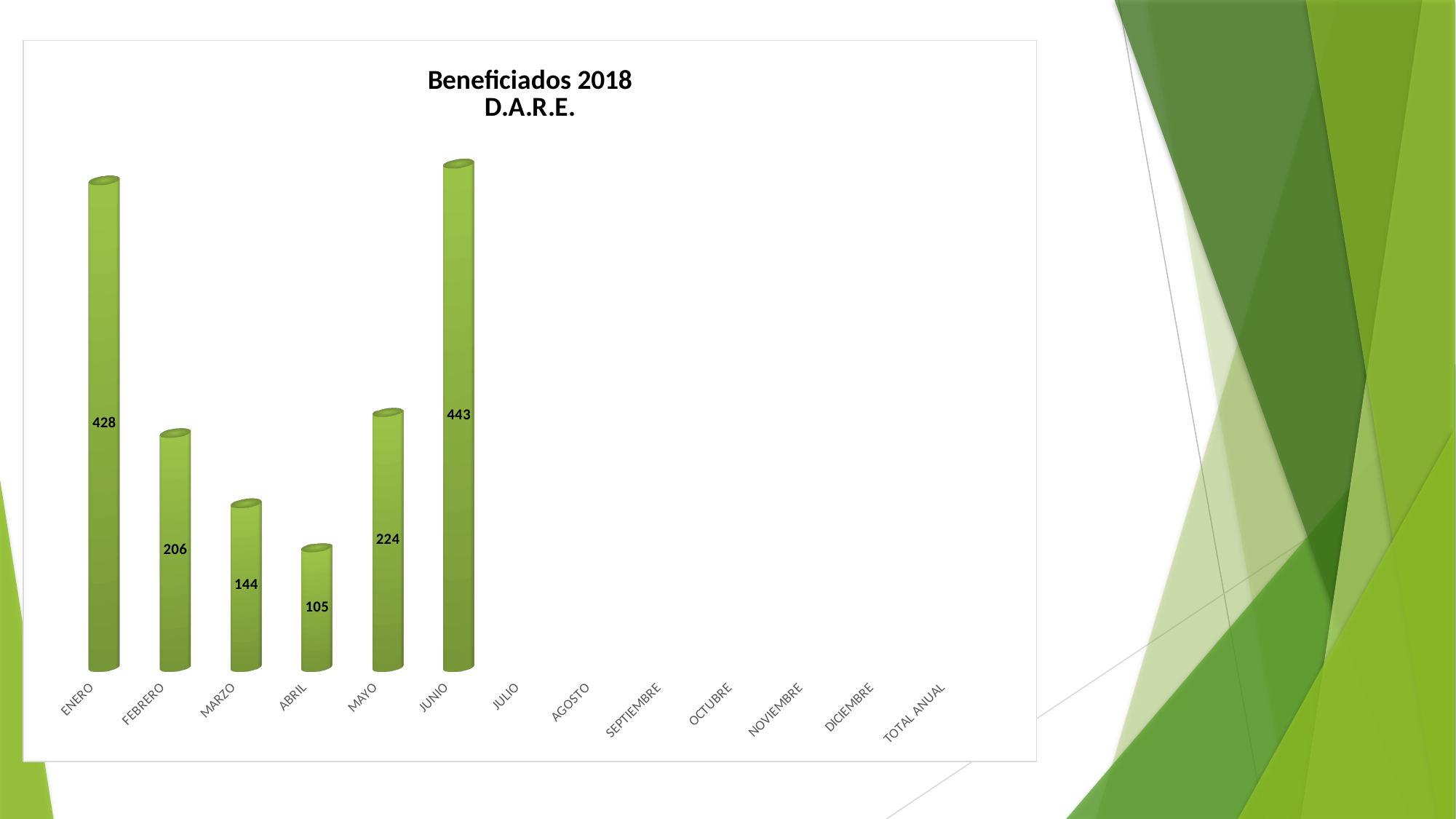
How many months have a plotted bar with a value? 6 Which is larger, the value for FEBRERO or the value for MAYO? MAYO What is the title of the chart? Beneficiados 2018 D.A.R.E. Which month with a plotted bar has the lowest value? ABRIL How many category labels are shown on the x axis? 13 What kind of chart is shown? bar chart What is the value for ABRIL? 105 Which month has the highest value? JUNIO What is the difference between the values for JUNIO and ENERO? 15 What is the difference between the values for FEBRERO and MARZO? 62 What is the value for MAYO? 224 What is the value for ENERO? 428